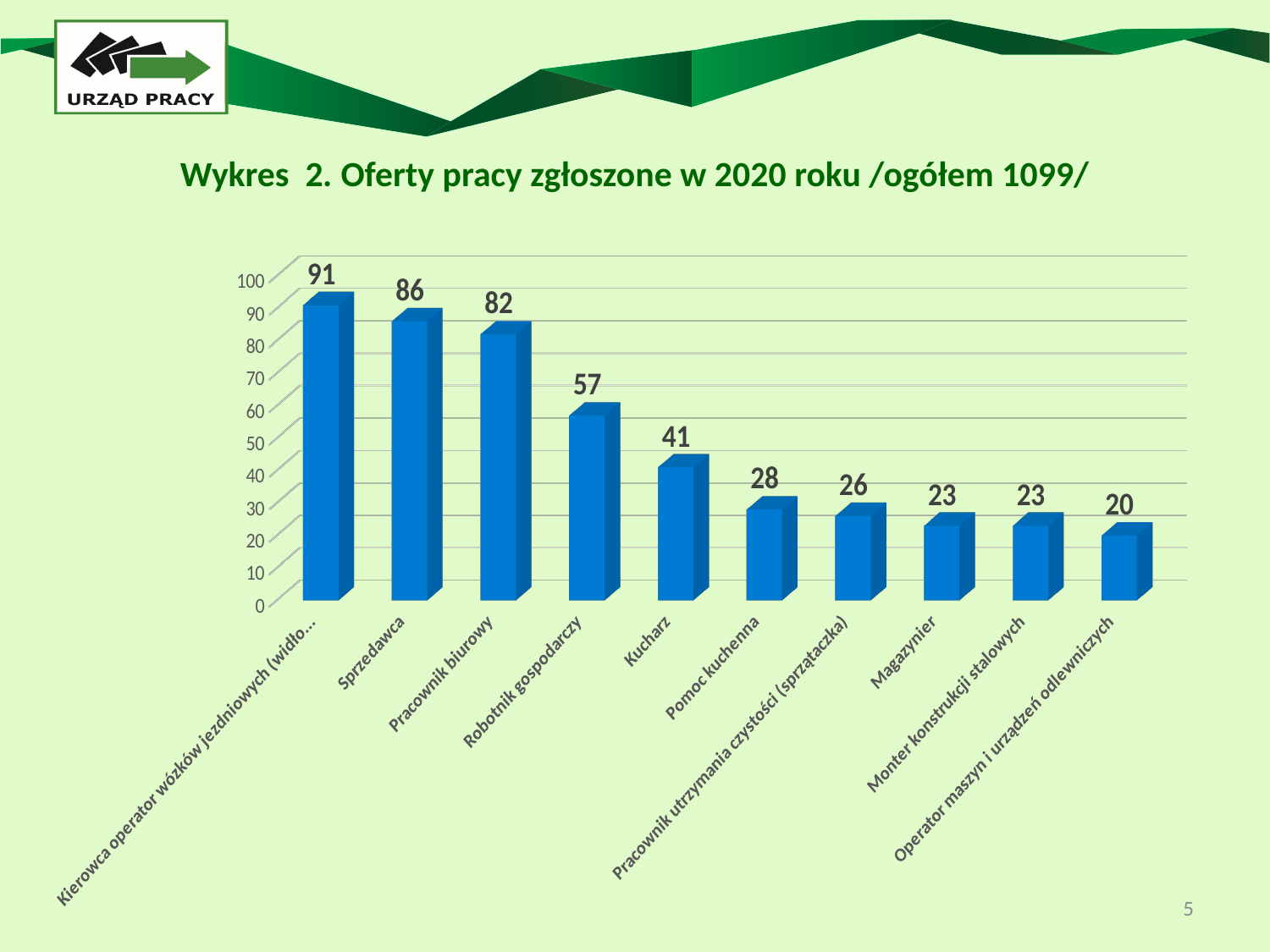
What is the value for Operator maszyn i urządzeń odlewniczych? 20 Which category has the highest value? Kierowca operator wózków jezdniowych (widło... Which category has the lowest value? Operator maszyn i urządzeń odlewniczych What is the value for Sprzedawca? 86 What kind of chart is shown on the slide? bar chart How many categories are shown on the chart? 10 What is the difference between the values for Robotnik gospodarczy and Kucharz? 16 What is the value for Kucharz? 41 What is the difference between the values for Sprzedawca and Pracownik biurowy? 4 What is the title of the chart? Wykres 2. Oferty pracy zgłoszone w 2020 roku /ogółem 1099/ Which is larger, the value for Pracownik utrzymania czystości (sprzątaczka) or the value for Magazynier? Pracownik utrzymania czystości (sprzątaczka) What is the value for Pomoc kuchenna? 28